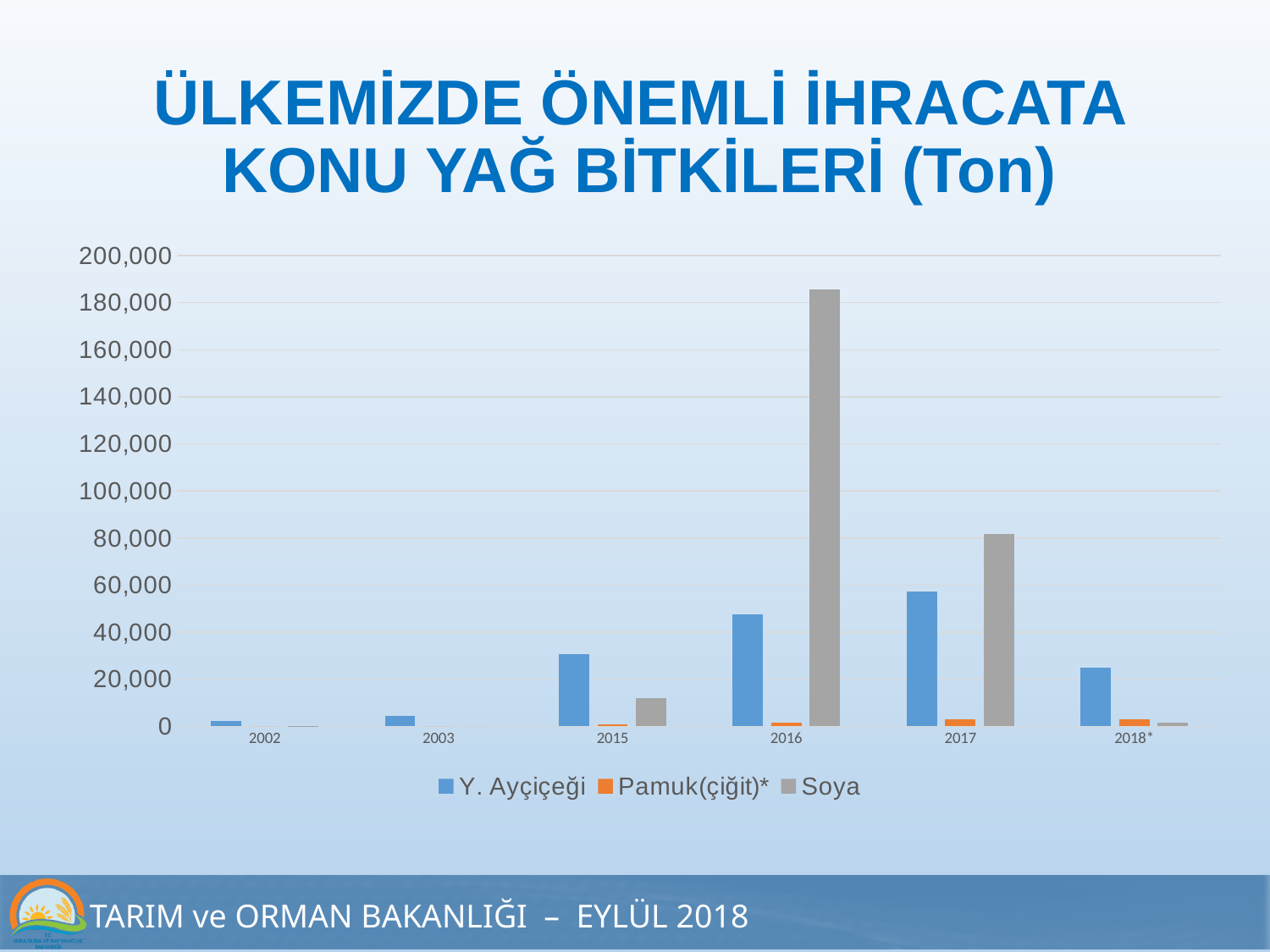
What kind of chart is shown on the slide? bar chart Is the Soya value for 2017 greater or less than 100,000? less How many years are shown on the x axis? 6 Is the Y. Ayçiçeği value for 2017 greater or less than 40,000? greater In which year is the Y. Ayçiçeği value highest? 2017 In which year is the Soya value highest? 2016 In 2016, which is larger: Soya or Y. Ayçiçeği? Soya How many series does the legend list? 3 Which colour represents Soya in the legend? gray In 2015, which is larger: Y. Ayçiçeği or Soya? Y. Ayçiçeği Is the Soya value for 2016 greater or less than 160,000? greater In which year is the Y. Ayçiçeği value lowest? 2002